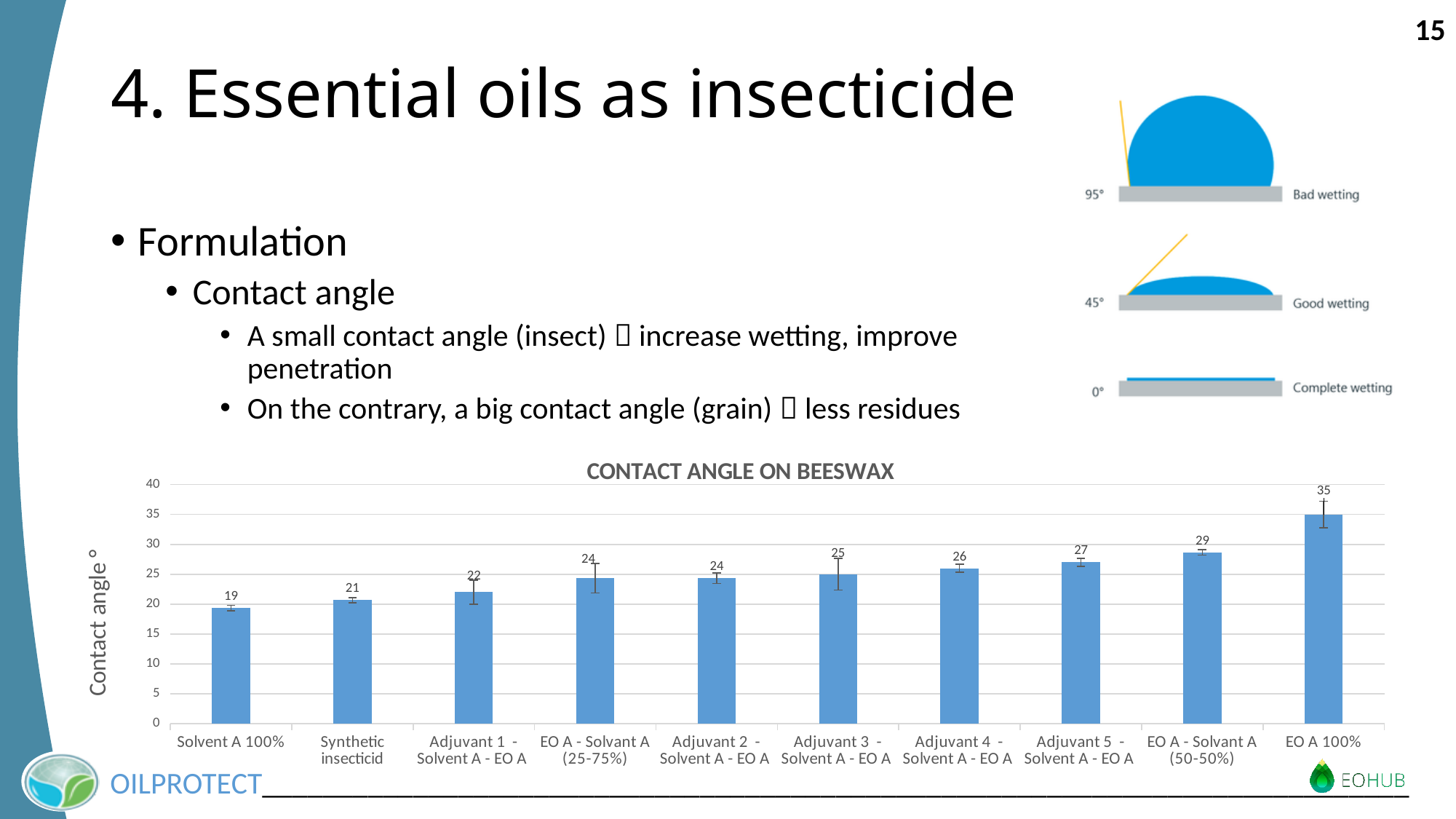
What is the contact angle value for Adjuvant 3 - Solvent A - EO A? 25 What is the contact angle value for EO A 100%? 35 Which category has the lowest contact angle? Solvent A 100% How many categories are shown on the x axis of the chart? 10 Is the value for EO A - Solvant A (25-75%) greater or less than 20? greater What is the title of the chart? CONTACT ANGLE ON BEESWAX What kind of chart is shown on the slide? bar chart What is the contact angle value for EO A - Solvant A (50-50%)? 29 What is the contact angle value for Solvent A 100%? 19 Which category has the highest contact angle? EO A 100% What is the difference between the contact angle for EO A 100% and Solvent A 100%? 16 Which has a larger contact angle, Synthetic insecticid or Adjuvant 5 - Solvent A - EO A? Adjuvant 5 - Solvent A - EO A